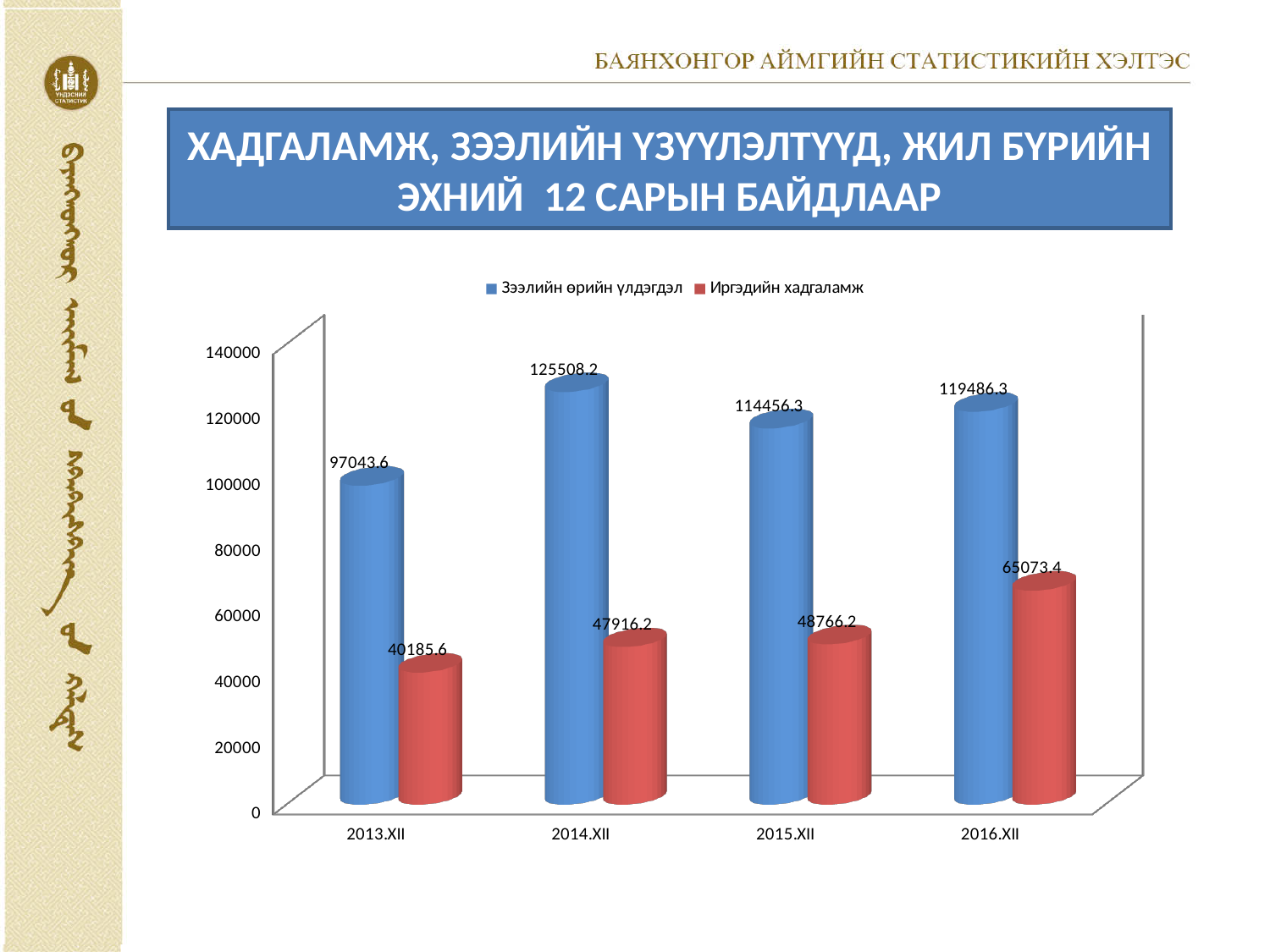
What is the value of Иргэдийн хадгаламж for 2016.XII? 65073.4 How many periods are shown on the x axis? 4 Is the value of Иргэдийн хадгаламж for 2015.XII greater or less than 60000? less What is the value of Зээлийн өрийн үлдэгдэл for 2014.XII? 125508.2 What kind of chart is shown on the slide? bar chart In which period is Иргэдийн хадгаламж lowest? 2013.XII What is the difference between Зээлийн өрийн үлдэгдэл and Иргэдийн хадгаламж in 2016.XII? 54412.9 Does Иргэдийн хадгаламж rise or fall from 2013.XII to 2016.XII? rise What is the value of Зээлийн өрийн үлдэгдэл for 2013.XII? 97043.6 In which period is Зээлийн өрийн үлдэгдэл highest? 2014.XII Which is larger: Зээлийн өрийн үлдэгдэл in 2015.XII or in 2016.XII? 2016.XII How many series does the legend list? 2